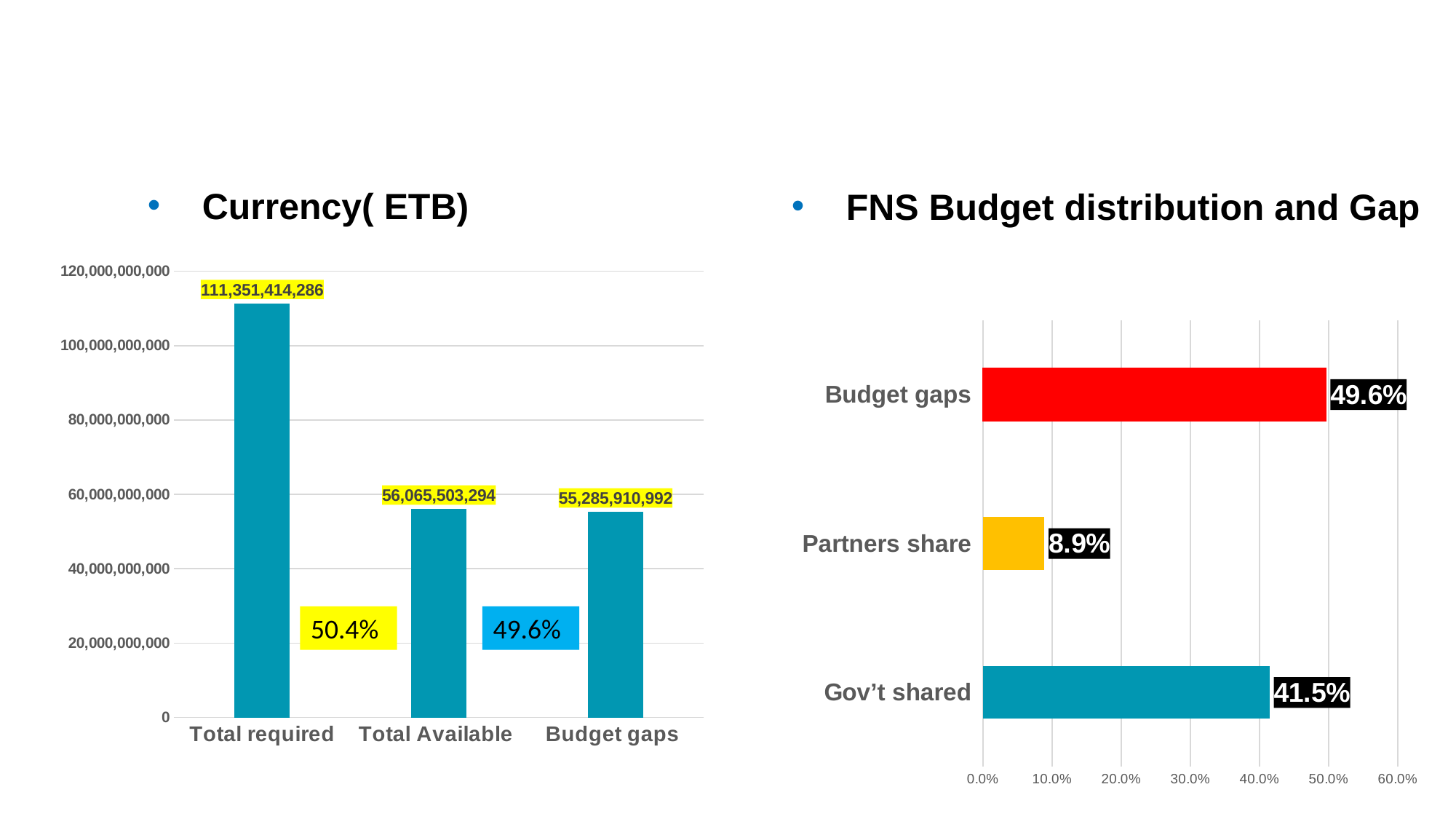
In the Currency( ETB) chart, what is the difference between Total required and Total Available? 55,285,910,992 In the Currency( ETB) chart, which category has the highest value? Total required In the Currency( ETB) chart, what is the value for Total required? 111,351,414,286 In the Currency( ETB) chart, what is the value for Total Available? 56,065,503,294 In the FNS Budget distribution and Gap chart, what is the difference between Budget gaps and Gov't shared? 8.1% What kind of chart is the FNS Budget distribution and Gap chart? Bar chart In the Currency( ETB) chart, how many categories are shown on the x axis? 3 In the FNS Budget distribution and Gap chart, what is the value for Partners share? 8.9% In the Currency( ETB) chart, what is the value for Budget gaps? 55,285,910,992 In the FNS Budget distribution and Gap chart, which is larger, Budget gaps or Gov't shared? Budget gaps In the FNS Budget distribution and Gap chart, what is the value for Gov't shared? 41.5% In the FNS Budget distribution and Gap chart, which category has the lowest value? Partners share